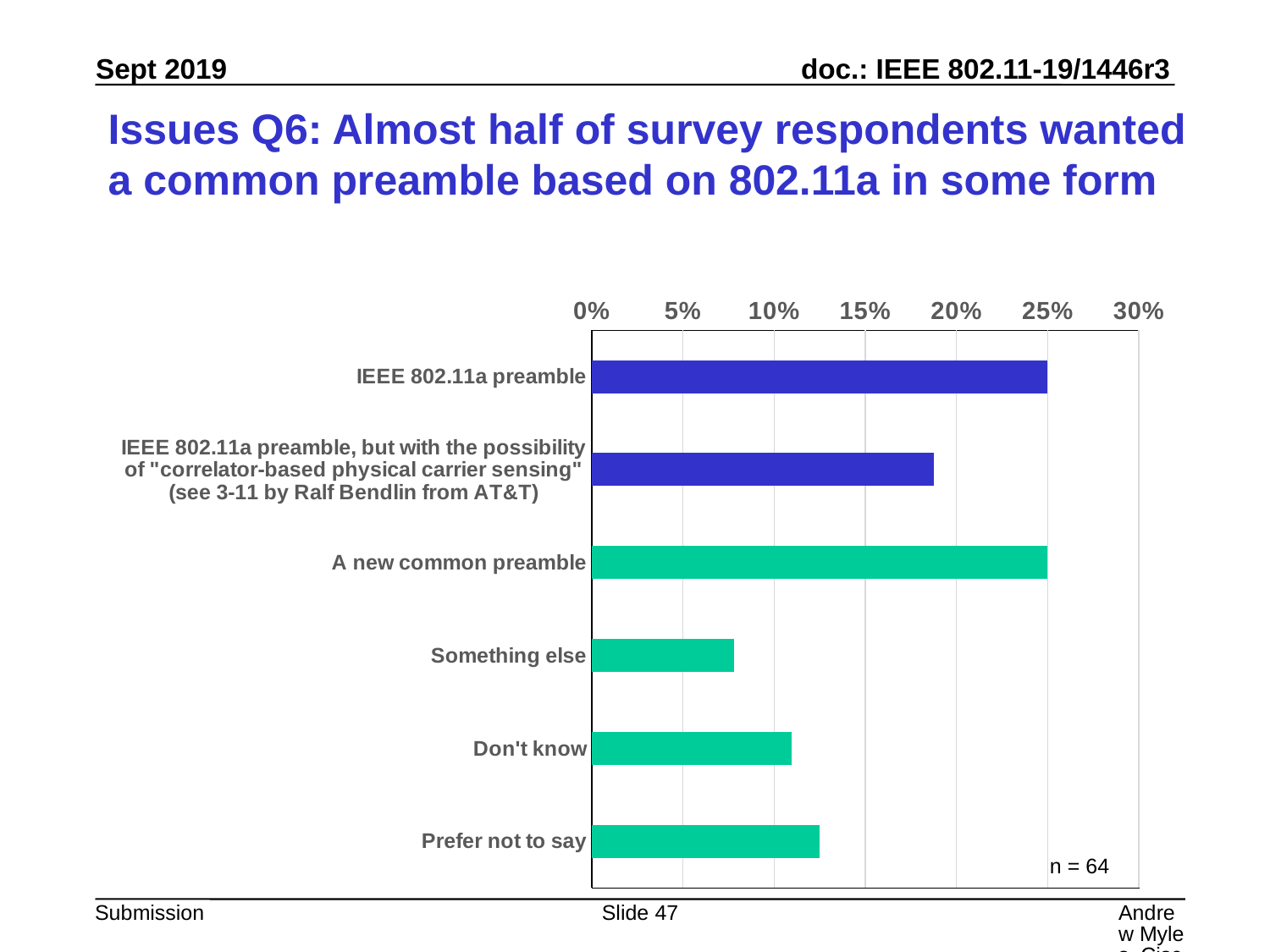
Which category has the lowest value in the chart? Something else Which is larger, the value for "IEEE 802.11a preamble" or the value for "Something else"? IEEE 802.11a preamble Is the value for "Something else" greater or less than 10%? less What sample size (n) is noted on the chart? n = 64 What kind of chart is shown on the slide? bar chart How many bars in the chart are coloured blue? 2 Is the value for "Prefer not to say" greater or less than 15%? less Is the value for "Don't know" greater or less than 10%? greater What is the value for "IEEE 802.11a preamble"? 25% How many categories are plotted in the chart? 6